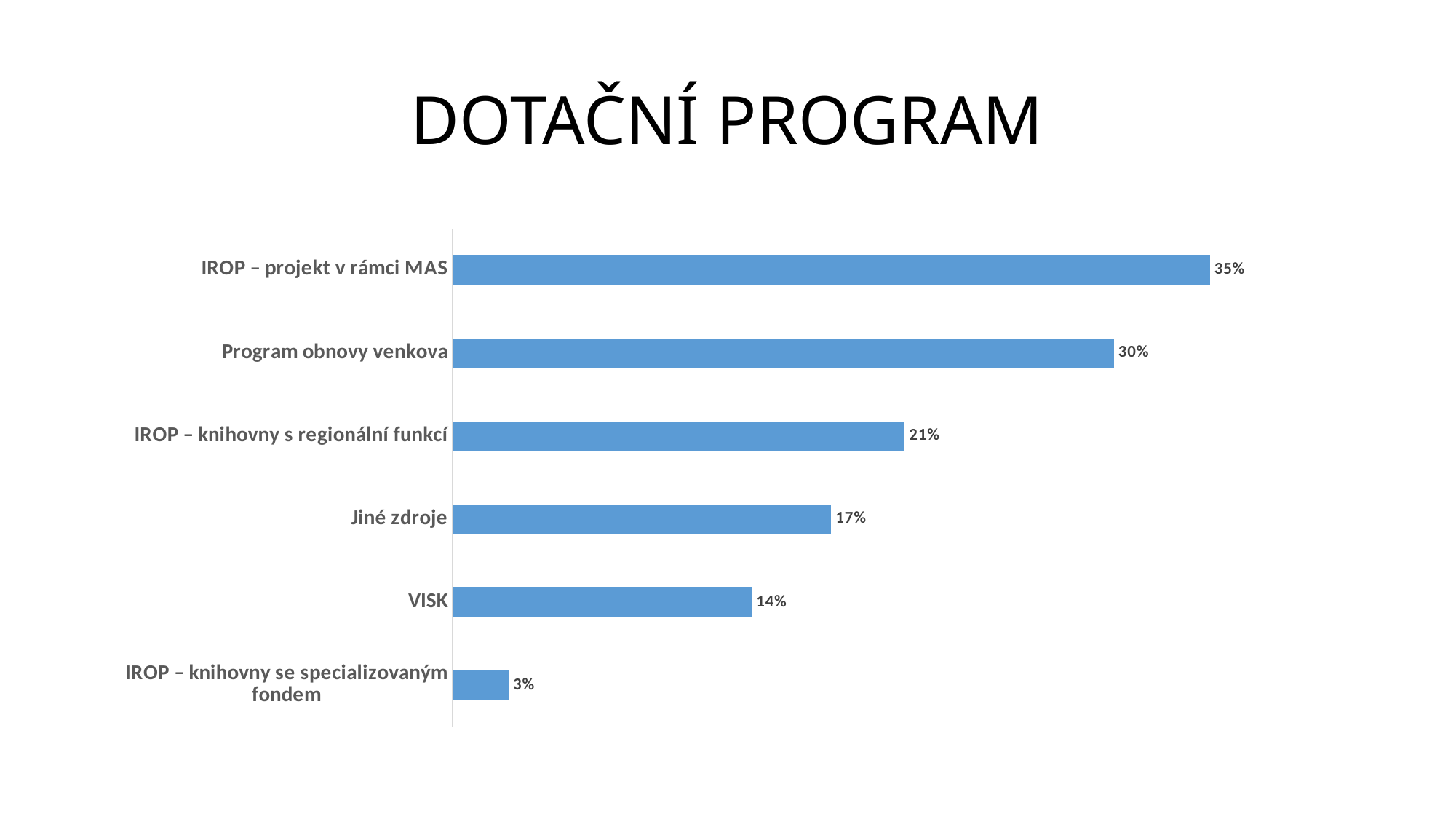
What is the difference between the values for IROP – knihovny s regionální funkcí and Jiné zdroje? 4% How many categories are shown in the chart? 6 What kind of chart is shown on the slide? Bar chart Which category has the highest value? IROP – projekt v rámci MAS What is the difference between the values for IROP – projekt v rámci MAS and Program obnovy venkova? 5% What is the value for IROP – projekt v rámci MAS? 35% What is the title of the slide? DOTAČNÍ PROGRAM What is the value for IROP – knihovny se specializovaným fondem? 3% What is the value for Program obnovy venkova? 30% Which category has the lowest value? IROP – knihovny se specializovaným fondem Which is larger, the value for Jiné zdroje or the value for VISK? Jiné zdroje What is the value for VISK? 14%